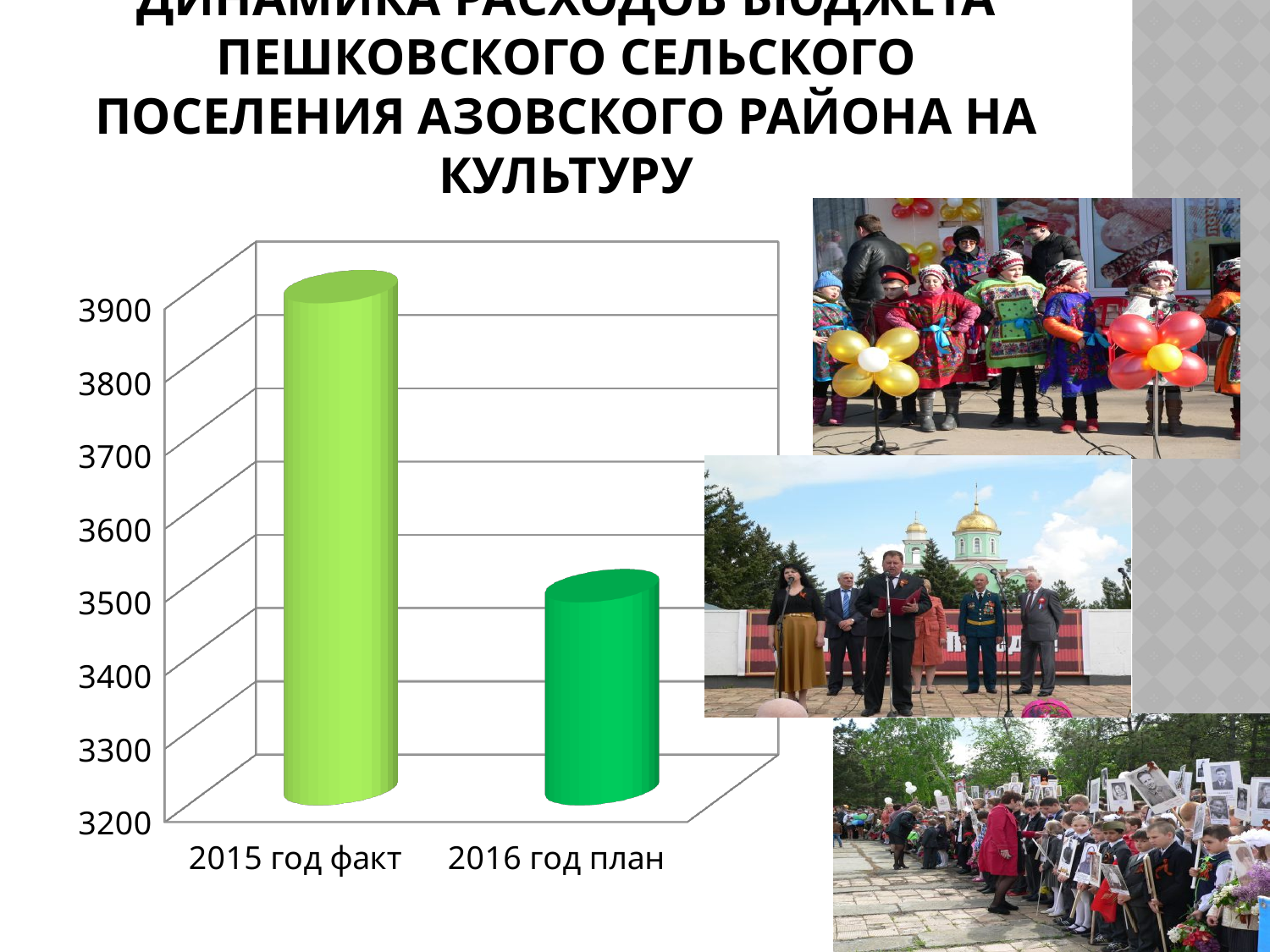
Is the value for 2016 год план greater or less than 3600? less Is the value for 2016 год план greater or less than 3400? greater How many categories are plotted on the chart? 2 Which category has the highest value on the chart? 2015 год факт Do the values rise or fall from 2015 год факт to 2016 год план? fall Is the value for 2015 год факт greater or less than 3800? greater What is the highest value shown on the vertical axis of the chart? 3900 Which is larger, the value for 2015 год факт or the value for 2016 год план? 2015 год факт What kind of chart is shown on the slide? bar chart What is the lowest value shown on the vertical axis of the chart? 3200 Which category has the lowest value on the chart? 2016 год план